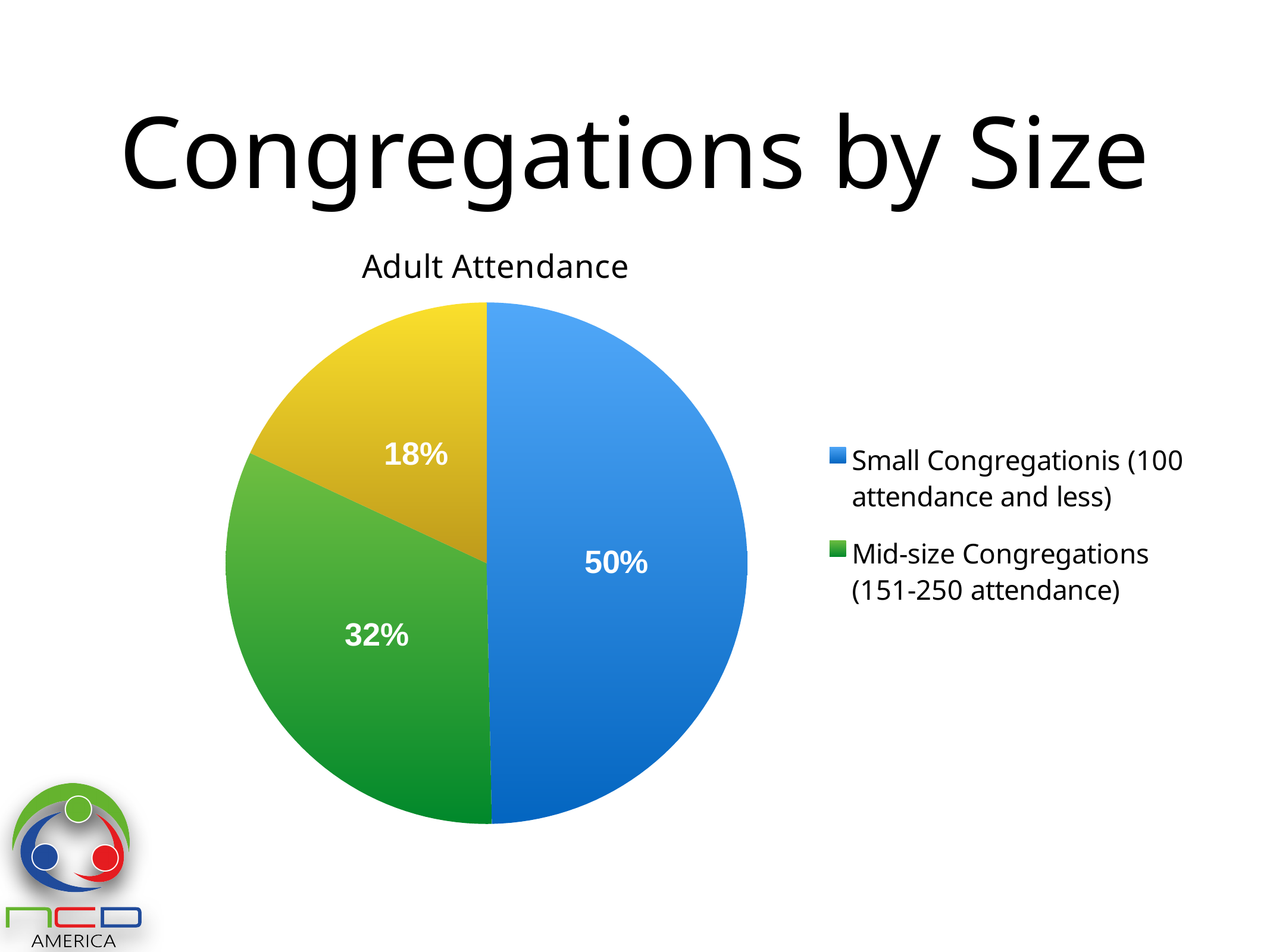
What type of chart is shown on the slide? Pie chart What percentage of the pie is Mid-size Congregations (151-250 attendance)? 32% What is the title of the chart? Adult Attendance What is the smallest percentage shown on the pie chart? 18% Which is larger: the Mid-size Congregations slice or the yellow slice? Mid-size Congregations What percentage is shown on the yellow slice of the pie? 18% How many entries does the legend list? 2 What percentage of the pie is Small Congregations (100 attendance and less)? 50% How many slices does the pie chart have? 3 How many percentage points larger is the Small Congregations slice than the Mid-size Congregations slice? 18 What colour is the slice for Small Congregations (100 attendance and less)? Blue Which category has the largest share of the pie? Small Congregations (100 attendance and less)